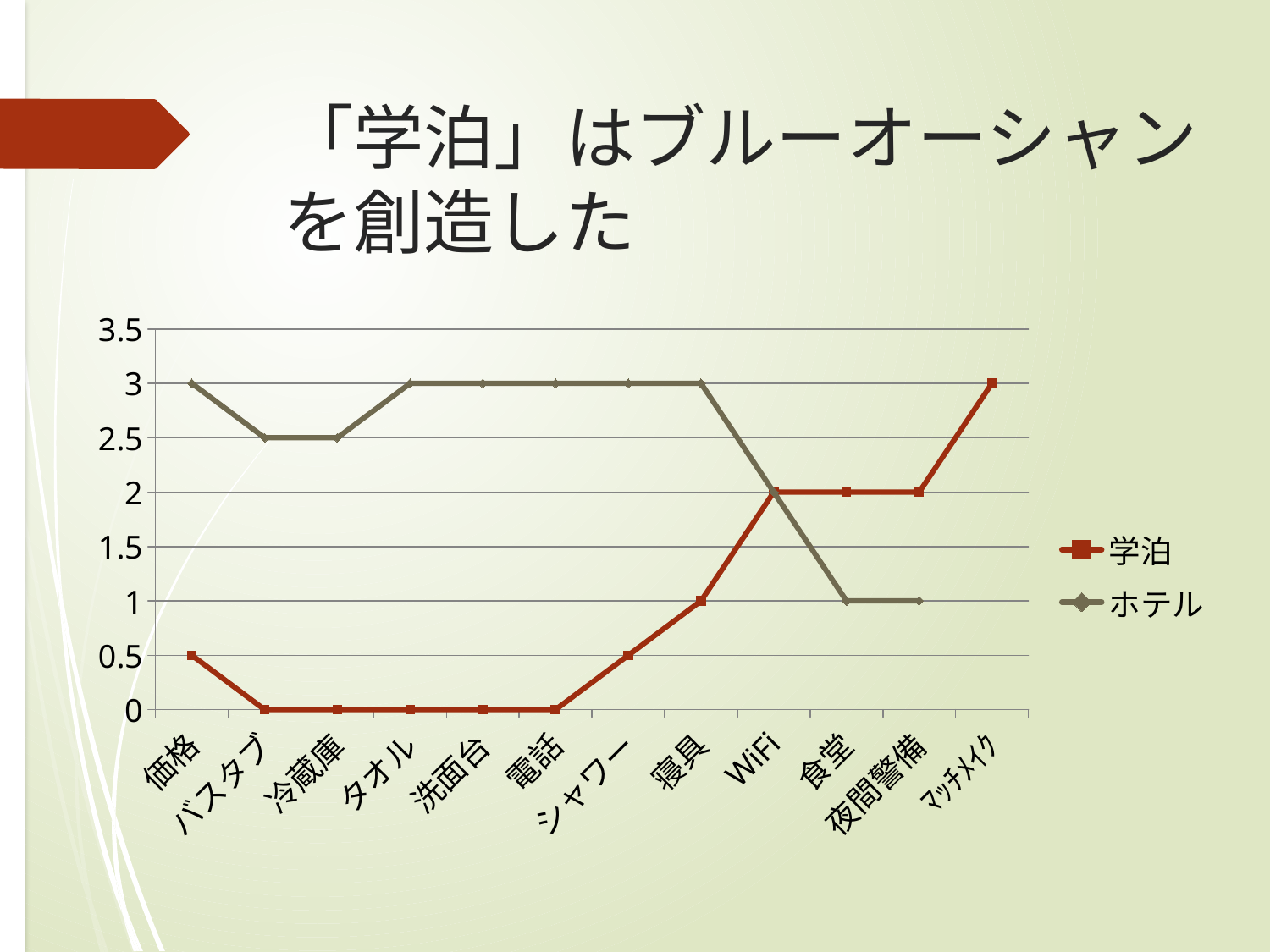
Which series is drawn in red? 学泊 How many categories are shown on the x axis? 12 What is the difference between ホテル and 学泊 at 電話? 3 What kind of chart is shown on the slide? line chart What is the value for 学泊 at 価格? 0.5 Which category has the highest value for 学泊? マッチメイク What is the value for ホテル at バスタブ? 2.5 What is the value for ホテル at 食堂? 1 Does the 学泊 line rise or fall from シャワー to WiFi? rise How many series does the legend list? 2 Which series has the larger value at 夜間警備, 学泊 or ホテル? 学泊 What is the value for 学泊 at マッチメイク? 3